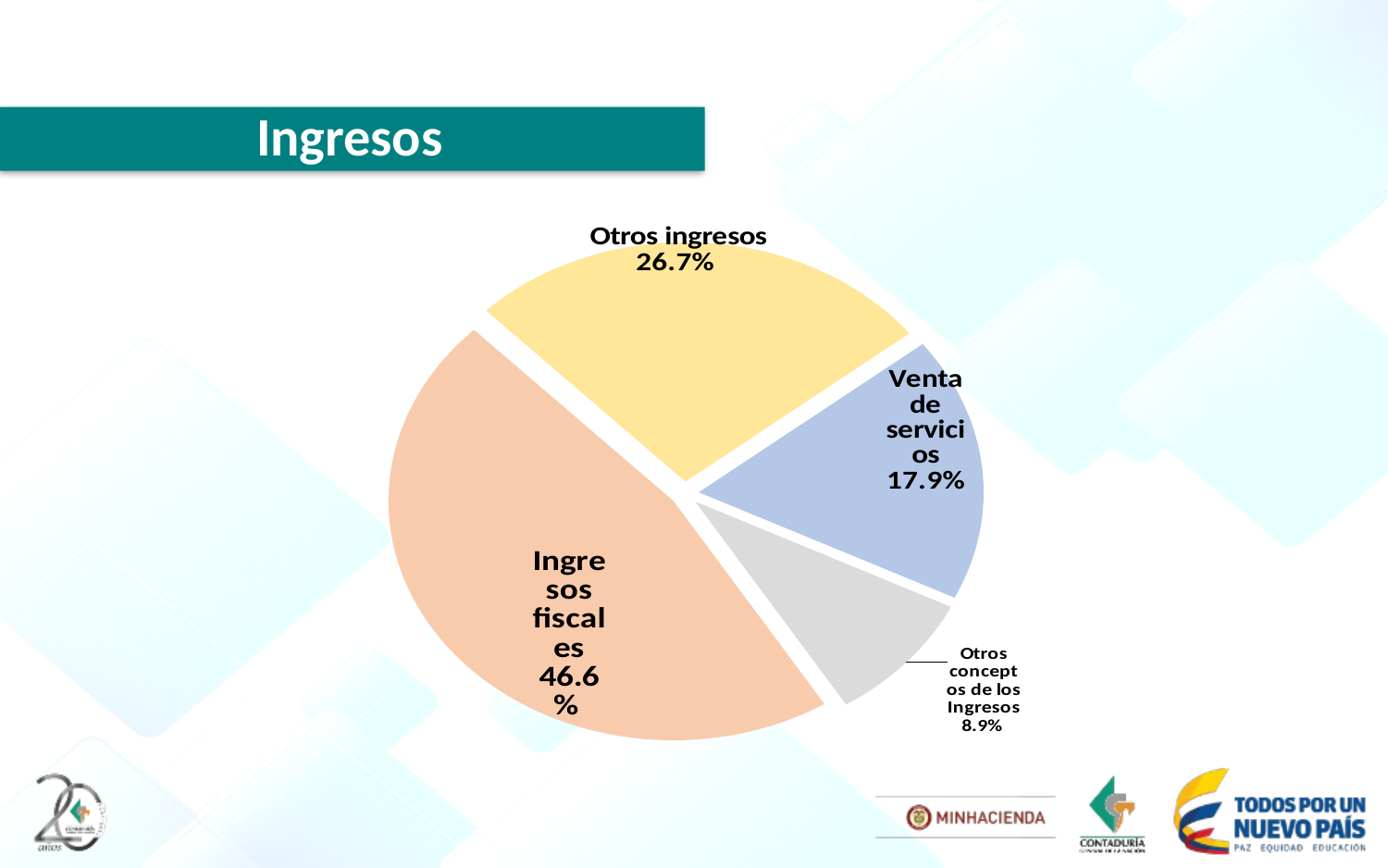
What share of the pie does Otros ingresos represent? 26.7% What share of the pie does Otros conceptos de los Ingresos represent? 8.9% What is the difference in percentage points between Venta de servicios and Otros conceptos de los Ingresos? 9 Which is larger, Otros ingresos or Venta de servicios? Otros ingresos What is the title shown above the chart? Ingresos Which category has the smallest slice of the pie? Otros conceptos de los Ingresos What share of the pie does Ingresos fiscales represent? 46.6% How many slices does the pie chart have? 4 Which category has the largest slice of the pie? Ingresos fiscales What kind of chart is shown on the slide? Pie chart What is the difference in percentage points between Ingresos fiscales and Otros ingresos? 19.9